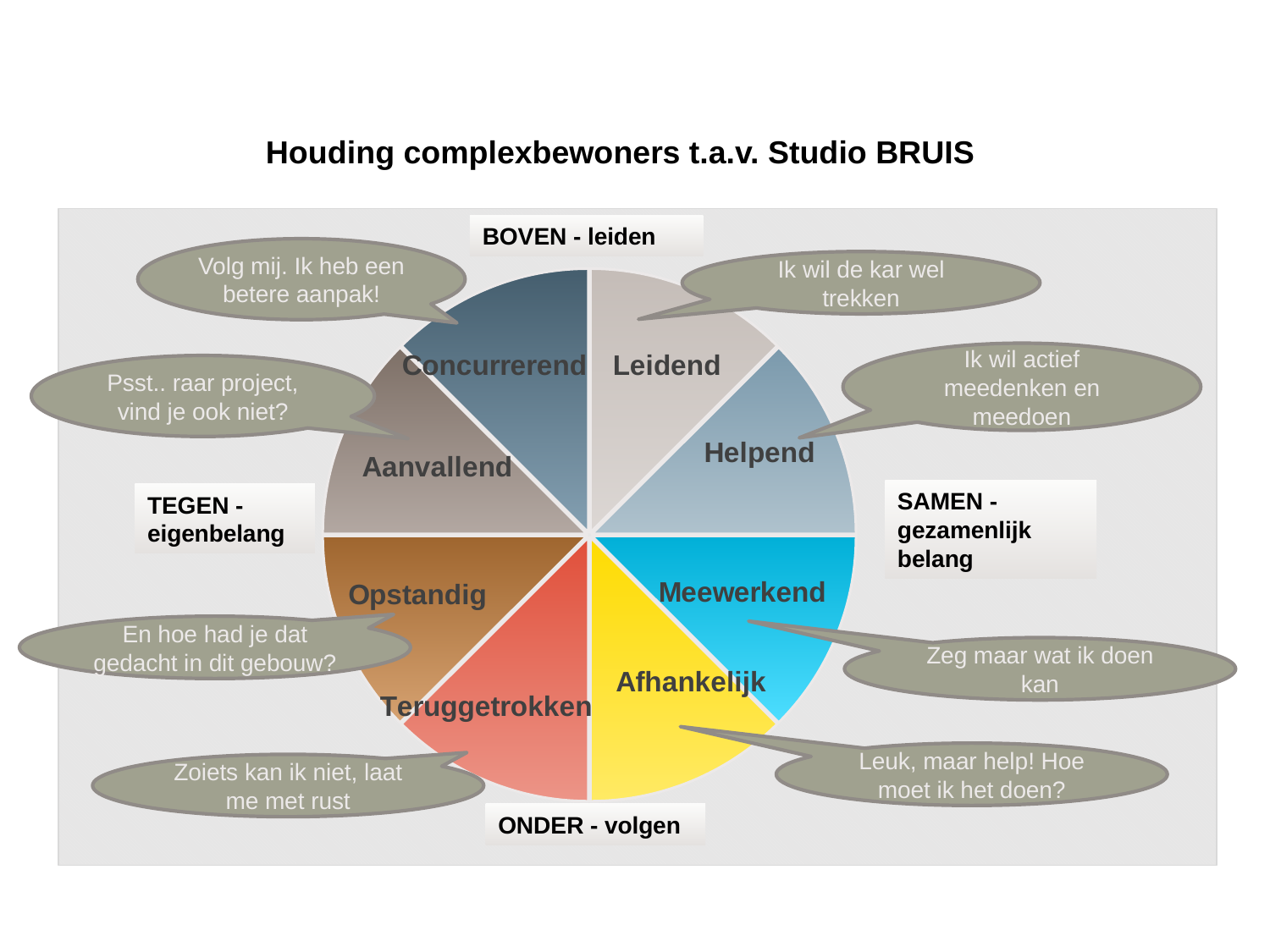
Which slice lies between Opstandig and Afhankelijk on the pie chart? Teruggetrokken What kind of chart is shown on the slide? Pie chart Which slice lies between Leidend and Meewerkend on the pie chart? Helpend How many slices does the pie chart have? 8 Which slice of the pie chart is coloured yellow? Afhankelijk What is the title of the chart? Houding complexbewoners t.a.v. Studio BRUIS Which slice is directly to the left of Leidend at the top of the pie chart? Concurrerend Which slice lies between Concurrerend and Opstandig on the pie chart? Aanvallend